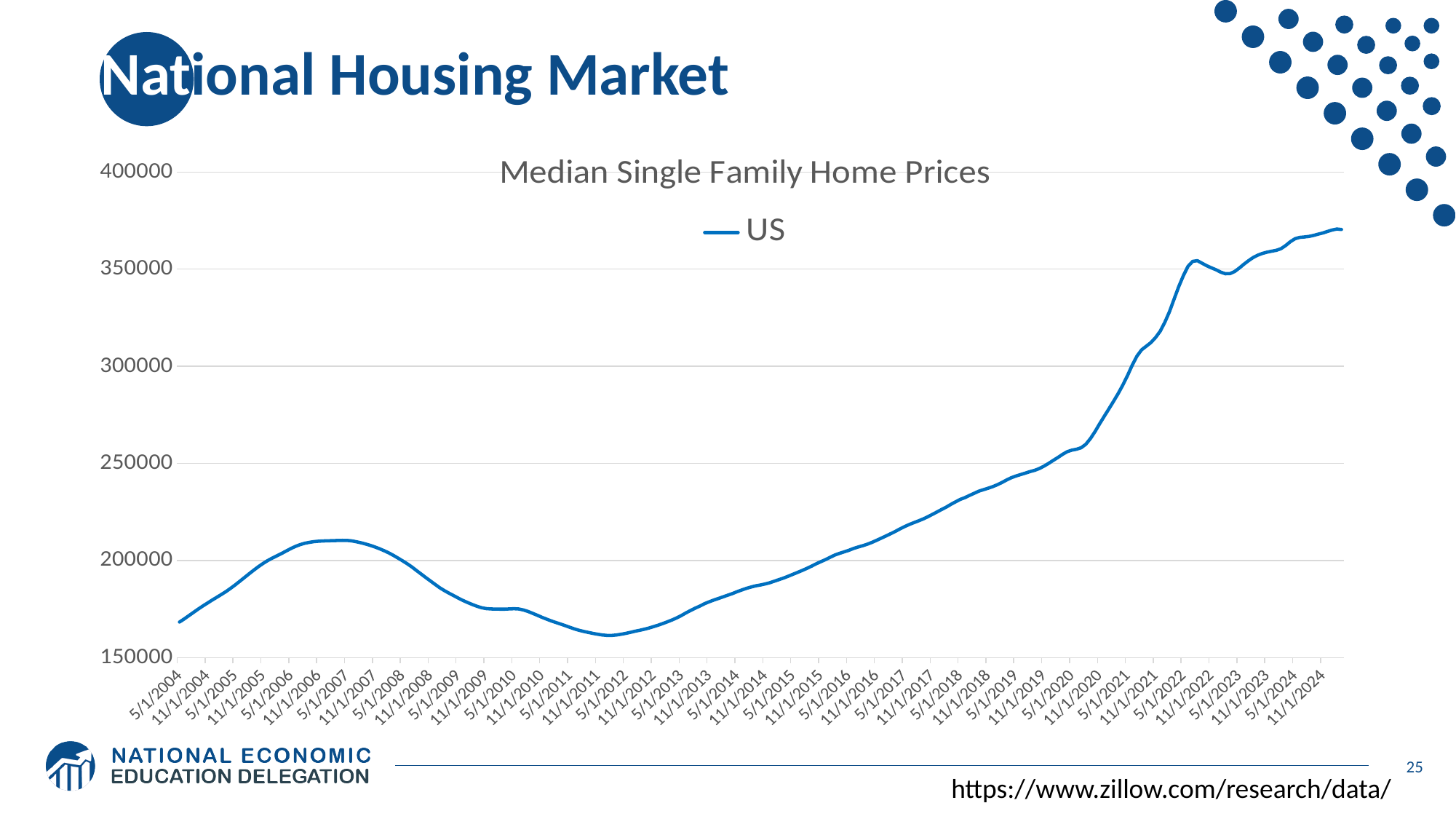
Which date on the x axis has the highest median home price? 11/1/2024 Is the value for 5/1/2004 greater or less than 200000? less Which is larger, the value for 5/1/2007 or the value for 5/1/2012? 5/1/2007 Does the median home price rise or fall between 5/1/2007 and 5/1/2012? fall How many series does the chart's legend list? 1 Is the value for 11/1/2018 greater or less than 250000? less What is the title of the chart? Median Single Family Home Prices What kind of chart is shown on the slide? line chart Is the value for 5/1/2012 greater or less than 200000? less What is the name of the series shown in the legend? US